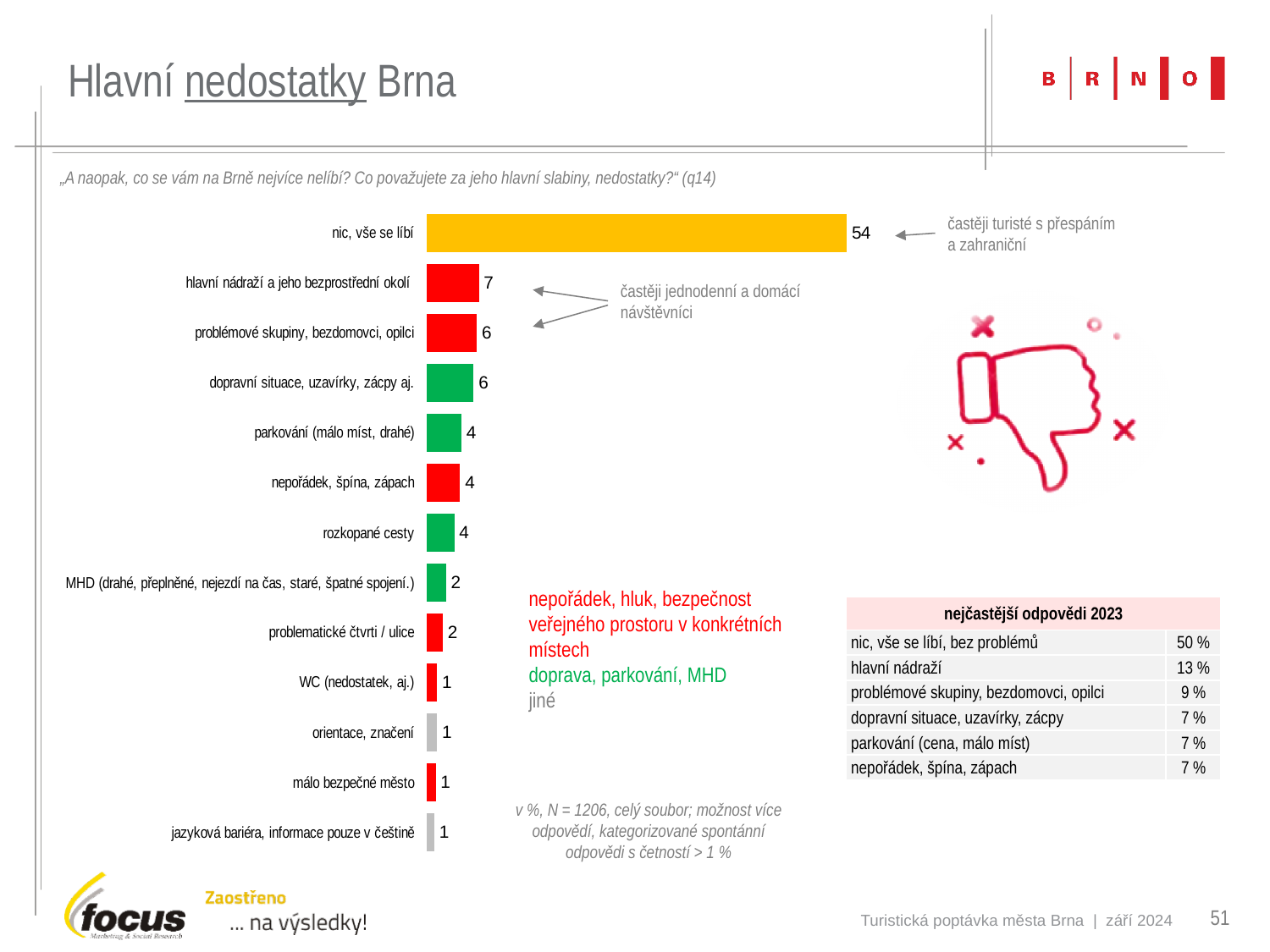
How many categories are plotted in the bar chart? 13 Which is larger, the value for "hlavní nádraží a jeho bezprostřední okolí" or the value for "problematické čtvrti / ulice"? hlavní nádraží a jeho bezprostřední okolí What value is shown for "WC (nedostatek, aj.)"? 1 What value is shown for "nic, vše se líbí"? 54 What colour is the bar for "nic, vše se líbí"? yellow What is the difference between the values for "dopravní situace, uzavírky, zácpy aj." and "rozkopané cesty"? 2 What value is shown for "hlavní nádraží a jeho bezprostřední okolí"? 7 What type of chart is shown on the slide? bar chart What value is shown for "parkování (málo míst, drahé)"? 4 What is the difference between the values for "nic, vše se líbí" and "hlavní nádraží a jeho bezprostřední okolí"? 47 What value is shown for "MHD (drahé, přeplněné, nejezdí na čas, staré, špatné spojení.)"? 2 Which category has the highest value in the chart? nic, vše se líbí